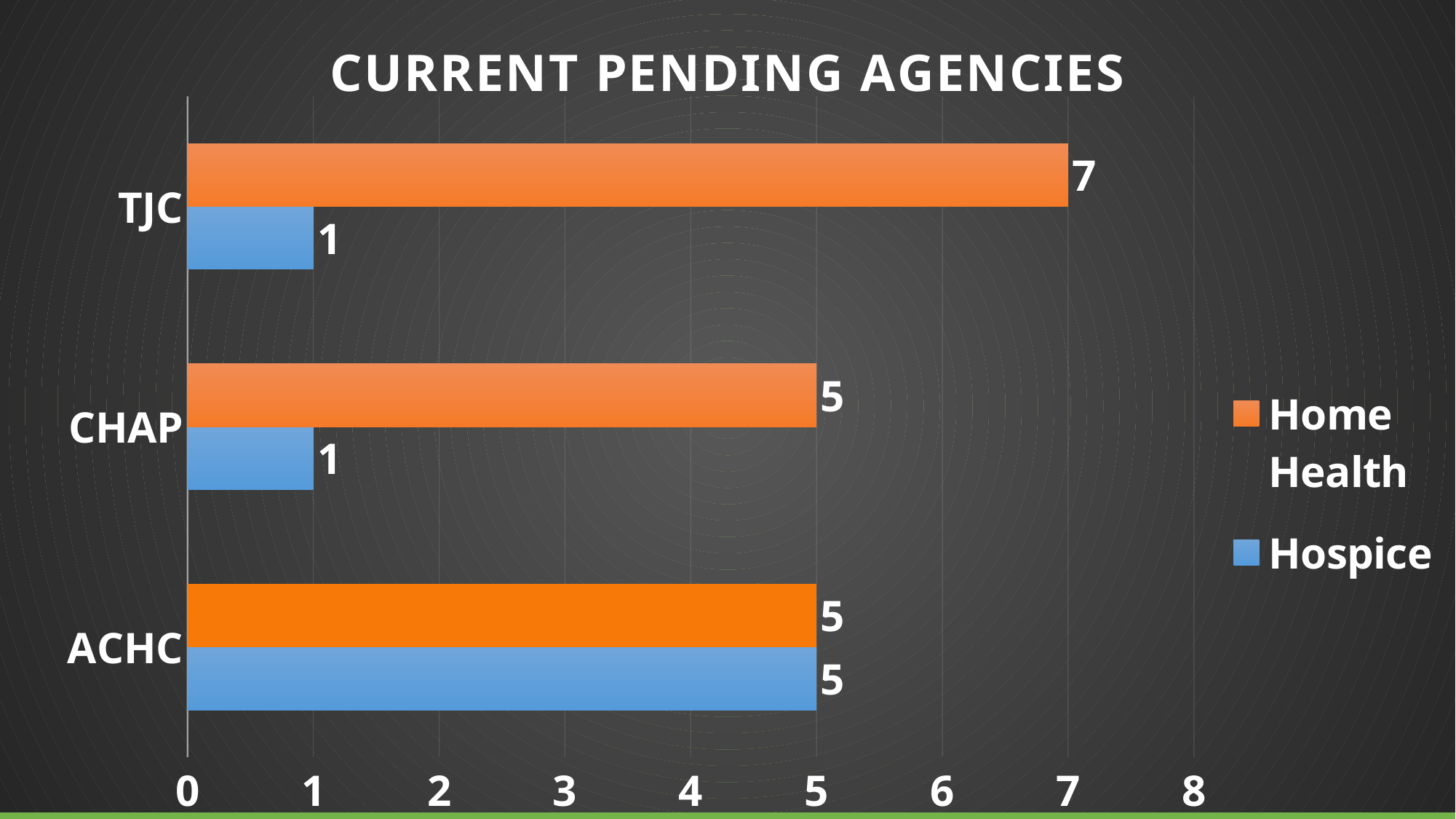
What is the difference between the Home Health and Hospice values for TJC? 6 What is the Hospice value for CHAP? 1 Which agency has the highest Hospice value? ACHC How many series does the legend list? 2 What is the Hospice value for ACHC? 5 How many agencies are shown on the chart? 3 Which is larger for CHAP, the Home Health value or the Hospice value? Home Health What kind of chart is shown on the slide? Bar chart What is the title of the chart? CURRENT PENDING AGENCIES Which agency has the highest Home Health value? TJC What is the Home Health value for CHAP? 5 What is the Home Health value for TJC? 7